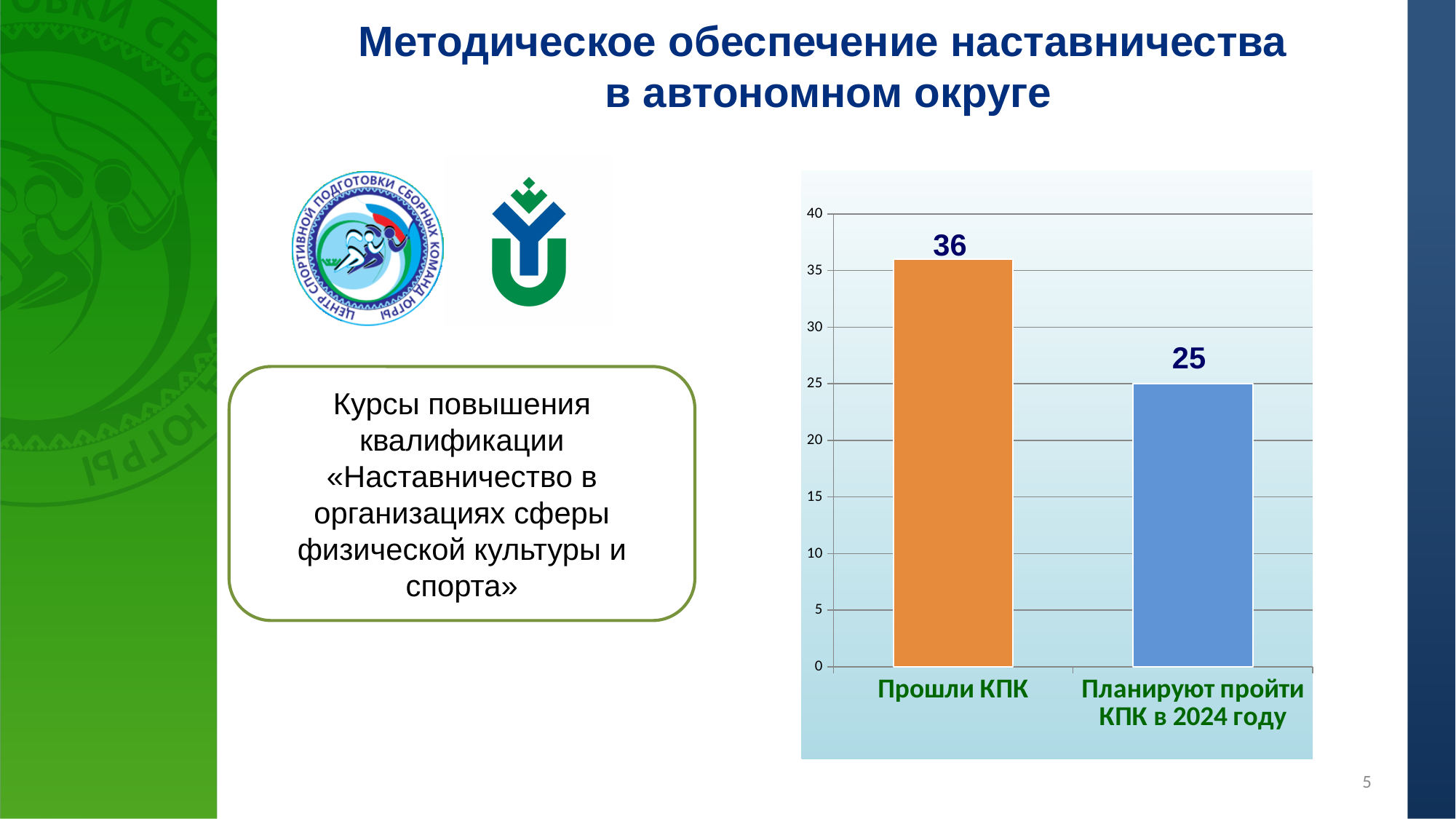
What is the value for "Планируют пройти КПК в 2024 году"? 25 Is the value for "Планируют пройти КПК в 2024 году" greater or less than 30? less Is the value for "Прошли КПК" greater or less than 35? greater What is the maximum value shown on the vertical axis? 40 What is the value for "Прошли КПК"? 36 Which category has the highest value? Прошли КПК What colour is the bar for "Прошли КПК"? orange Which is larger: the value for "Прошли КПК" or the value for "Планируют пройти КПК в 2024 году"? Прошли КПК How many categories are shown in the chart? 2 Which category has the lowest value? Планируют пройти КПК в 2024 году What is the difference between the values for "Прошли КПК" and "Планируют пройти КПК в 2024 году"? 11 What kind of chart is shown on the slide? bar chart